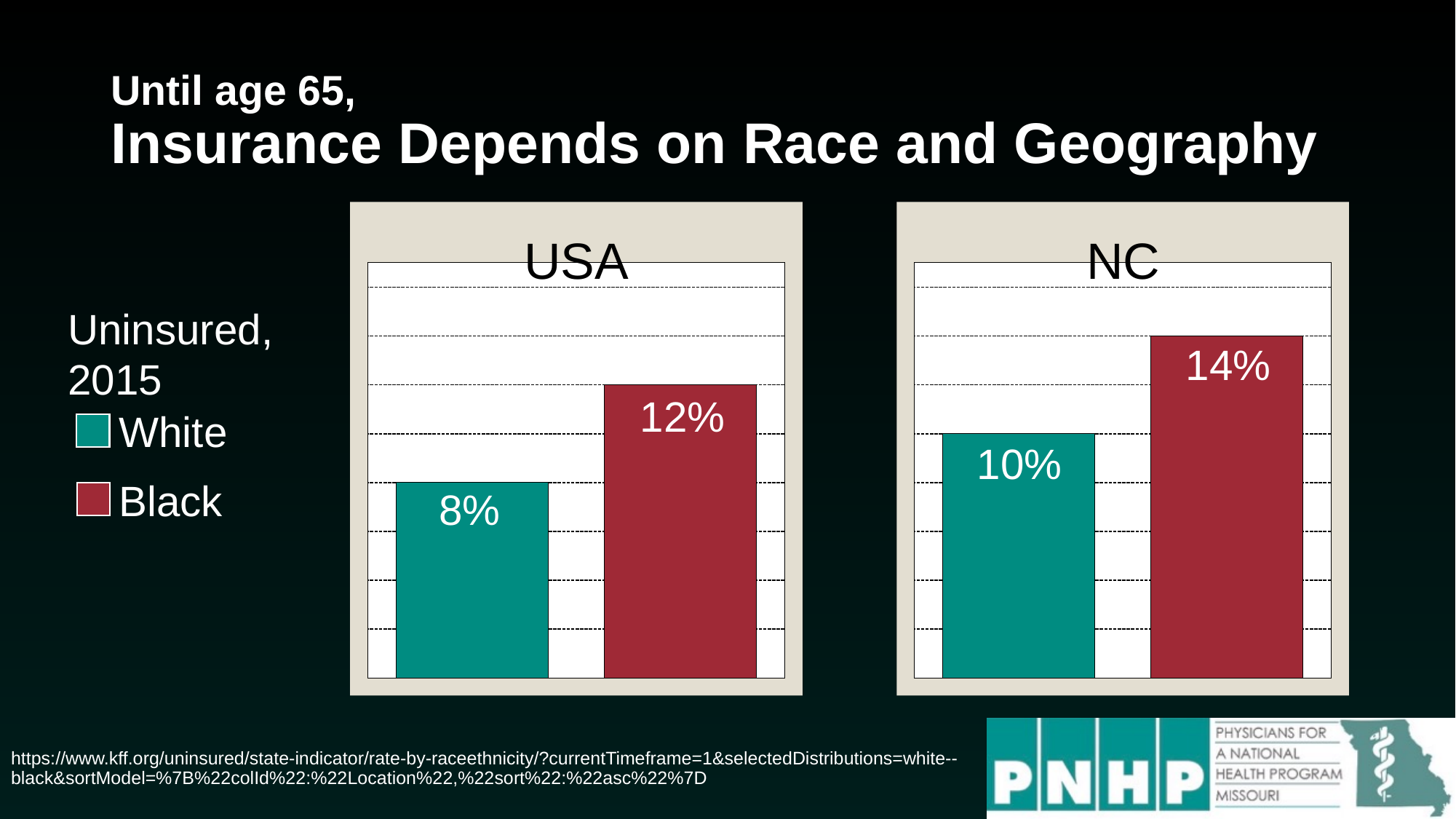
In the NC chart, what is the uninsured rate for White? 10% In the USA chart, what is the uninsured rate for White? 8% In the USA chart, what is the uninsured rate for Black? 12% In the NC chart, which group has the higher uninsured rate? Black How many bars are shown in the NC chart? 2 In the NC chart, what is the uninsured rate for Black? 14% How many series does the legend list? 2 What type of chart is the USA chart? Bar chart In the USA chart, which group has the lower uninsured rate? White In the NC chart, what is the difference between the Black and White uninsured rates? 4% In the USA chart, what is the difference between the Black and White uninsured rates? 4% Is the White uninsured rate higher in the USA chart or the NC chart? NC